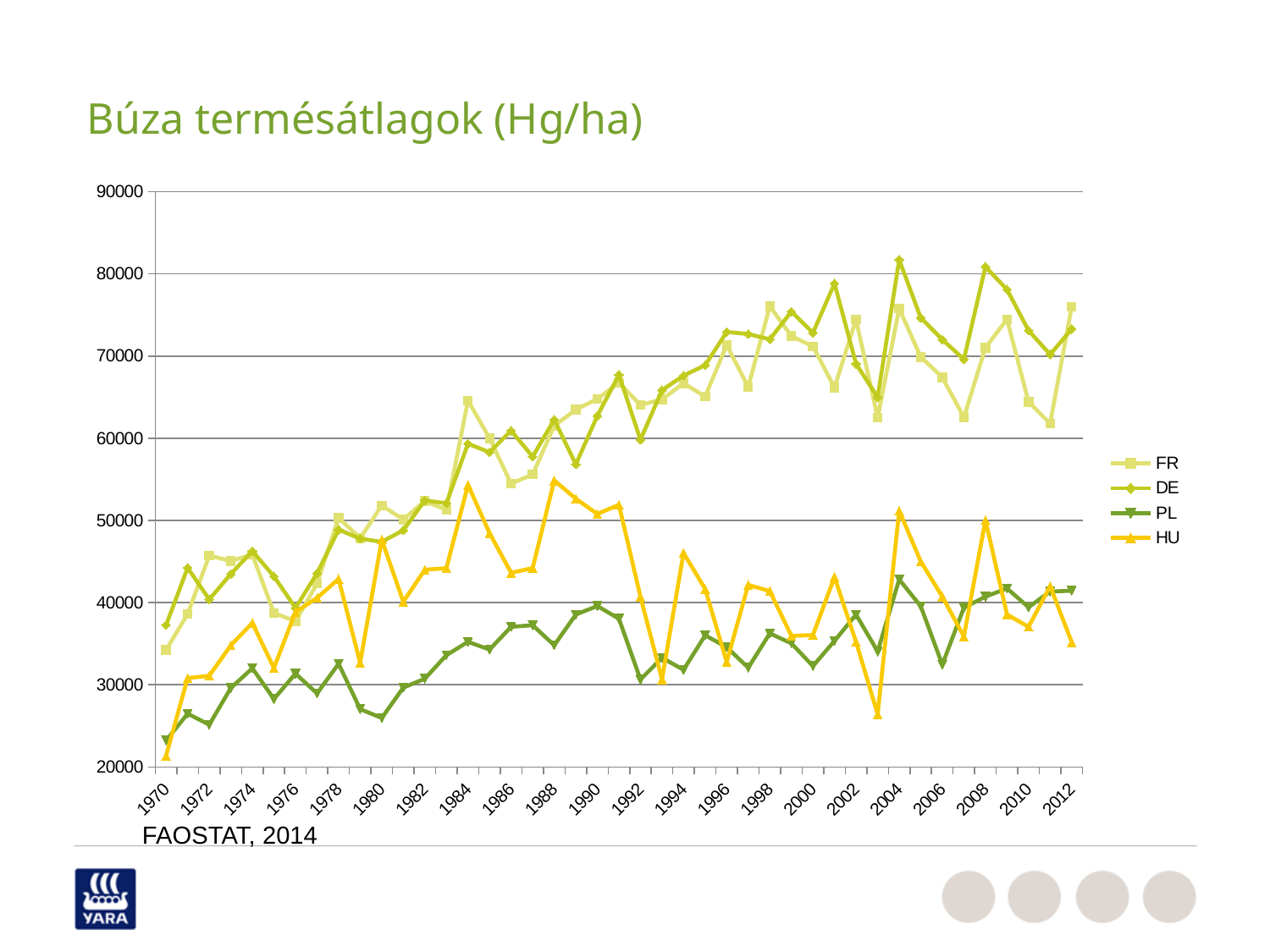
What is the title of the chart? Búza termésátlagok (Hg/ha) Which series are listed in the legend? FR, DE, PL, HU In 2012, which series has the larger value, DE or HU? DE What kind of chart is shown on the slide? line chart Is the value for FR in 1984 greater or less than 60000? greater Is the value for DE in 2004 greater or less than 80000? greater In 1990, which series has the larger value, HU or PL? HU How many series does the legend list? 4 Which series has the highest value in 2008? DE Is the value for PL in 1970 greater or less than 30000? less Overall, does the PL series rise or fall from 1970 to 2012? rise